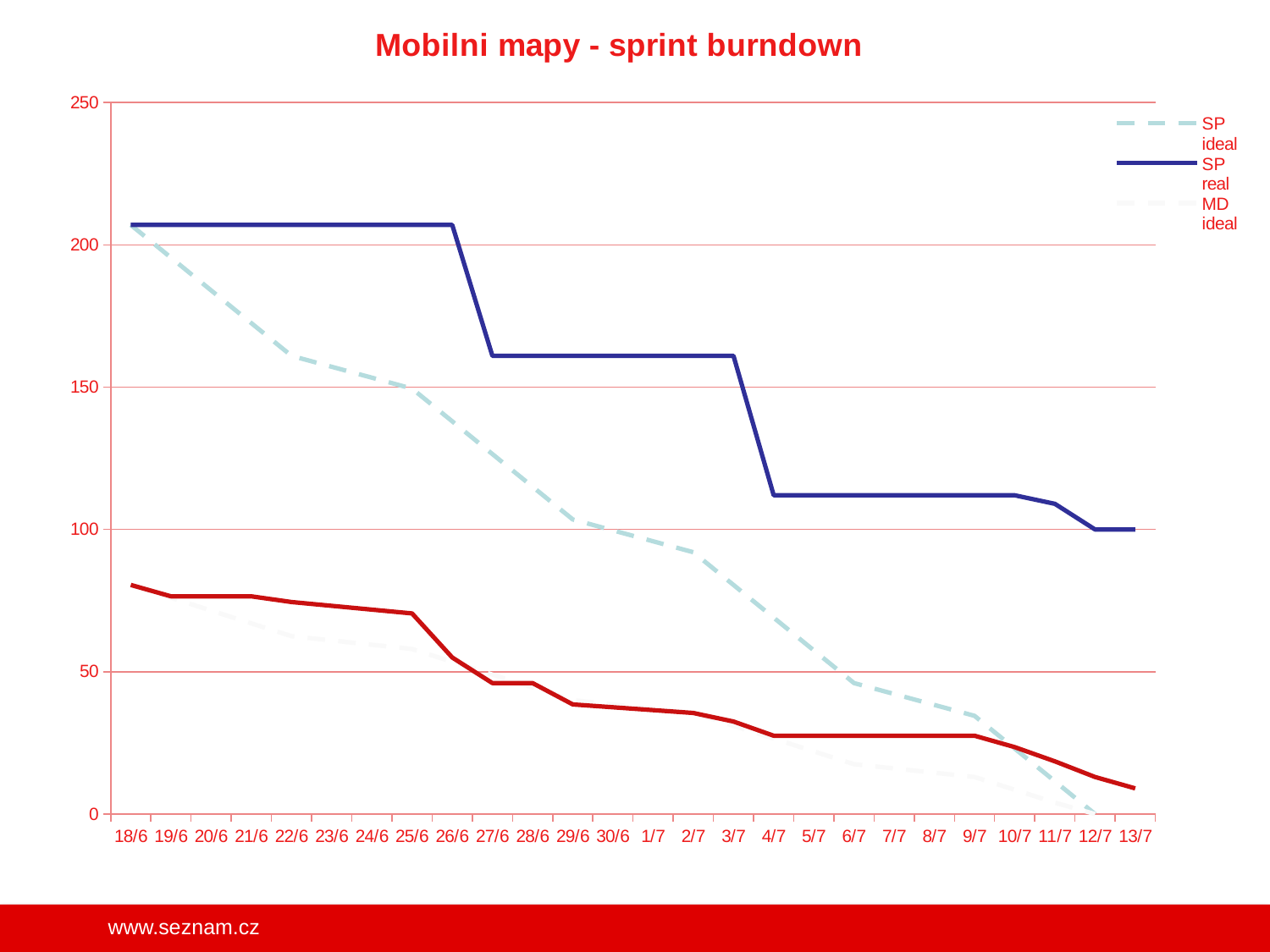
What kind of chart is shown on the slide? line chart Is the value of SP real on 18/6 greater or less than 200? greater Is the value of SP real on 4/7 greater or less than 100? greater How many series does the legend list? 3 What is the value of SP real on 13/7? 100 Is the value of SP real on 27/6 greater or less than 150? greater What is the value of SP ideal on 12/7? 0 How many dates are shown on the x axis? 26 What is the title of the chart? Mobilni mapy - sprint burndown Does the SP real series rise or fall from 18/6 to 13/7? fall